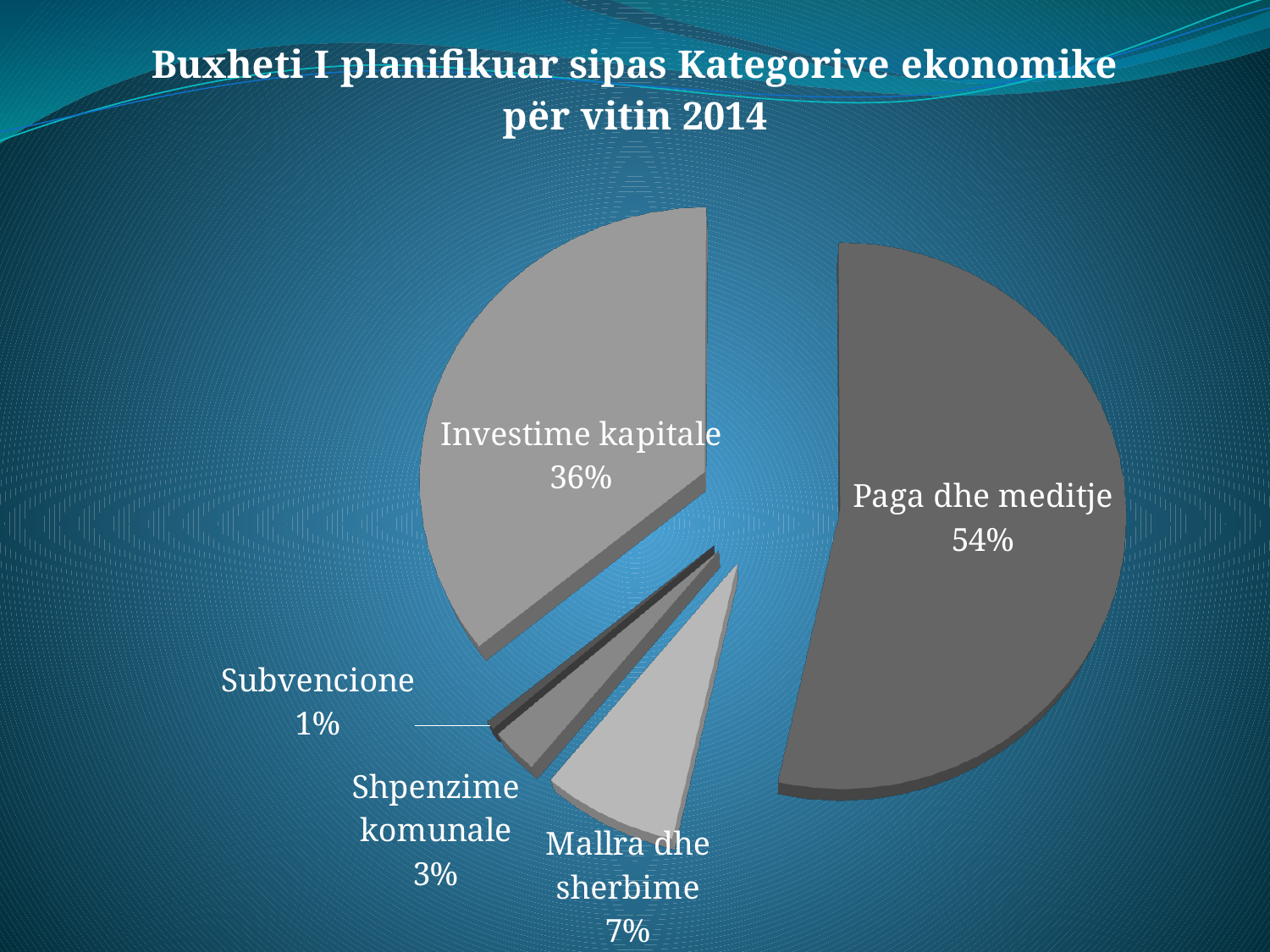
What kind of chart is shown on the slide? Pie chart Which category has the smallest share of the pie? Subvencione Which is larger, Mallra dhe sherbime or Shpenzime komunale? Mallra dhe sherbime What is the value shown for Investime kapitale? 36% What is the difference in percentage points between Paga dhe meditje and Investime kapitale? 18 How many categories are shown in the pie chart? 5 What share of the pie does Paga dhe meditje represent? 54% What is the value shown for Shpenzime komunale? 3% What is the title of the chart? Buxheti I planifikuar sipas Kategorive ekonomike për vitin 2014 What is the value shown for Mallra dhe sherbime? 7% What is the value shown for Subvencione? 1% Which category has the largest share of the pie? Paga dhe meditje